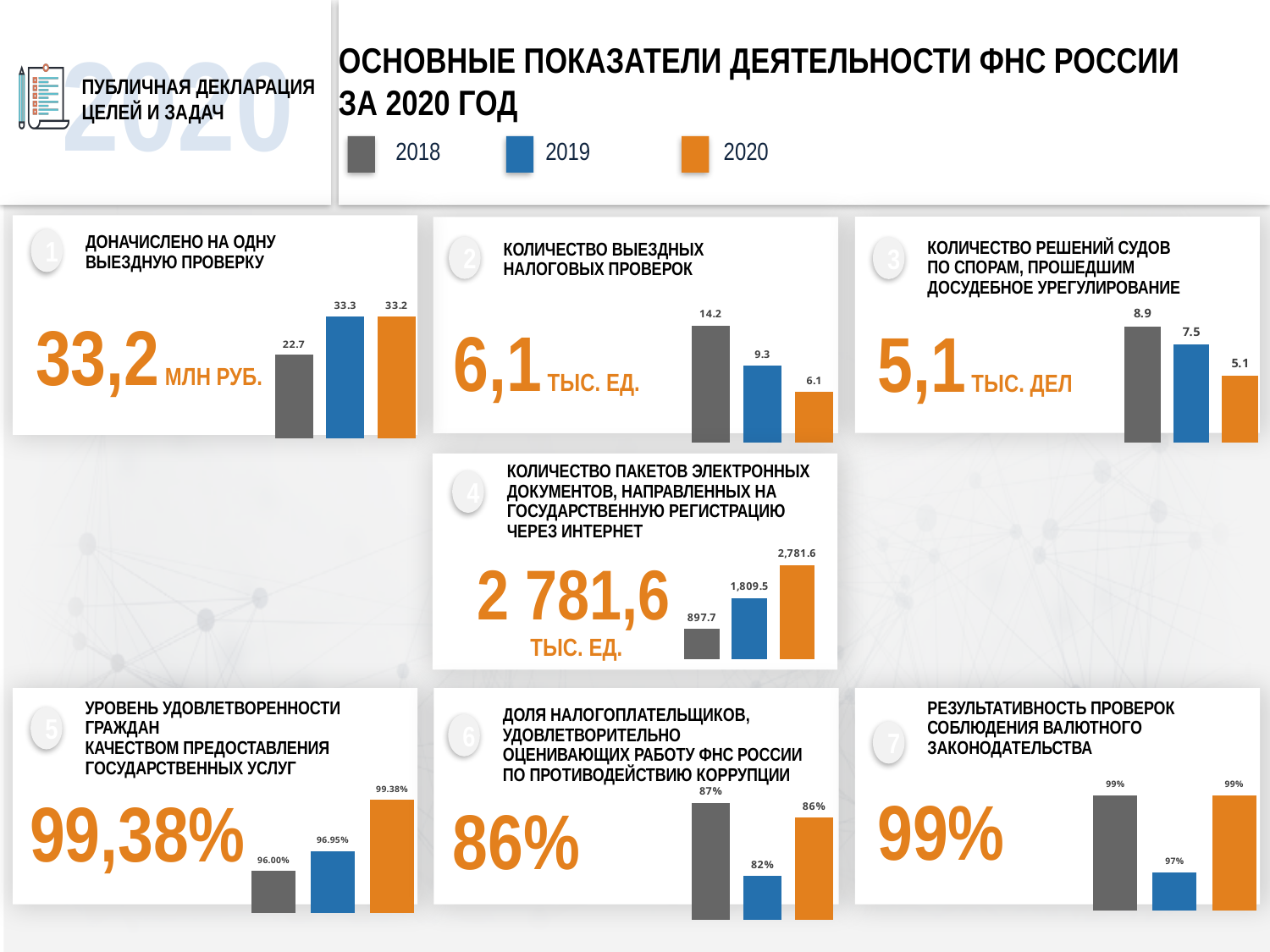
In chart 2 (Количество выездных налоговых проверок), do the values rise or fall from 2018 to 2020? fall In chart 4 (Количество пакетов электронных документов), what is the value for 2019? 1,809.5 In chart 3 (Количество решений судов по спорам), what is the difference between the 2018 and 2020 values? 3.8 In chart 7 (Результативность проверок соблюдения валютного законодательства), which year has the lowest value? 2019 In chart 6 (Доля налогоплательщиков, удовлетворительно оценивающих работу ФНС), what is the value for 2019? 82% In chart 4 (Количество пакетов электронных документов), do the values rise or fall from 2018 to 2020? rise In chart 5 (Уровень удовлетворенности граждан), what is the value for 2019? 96.95% In chart 6 (Доля налогоплательщиков, удовлетворительно оценивающих работу ФНС), which is larger: the 2018 value or the 2020 value? 2018 In chart 3 (Количество решений судов по спорам), which year has the lowest value? 2020 In chart 1 (Доначислено на одну выездную проверку), what is the value for 2018? 22.7 In chart 2 (Количество выездных налоговых проверок), which year has the highest value? 2018 How many series does the legend at the top of the slide list? 3